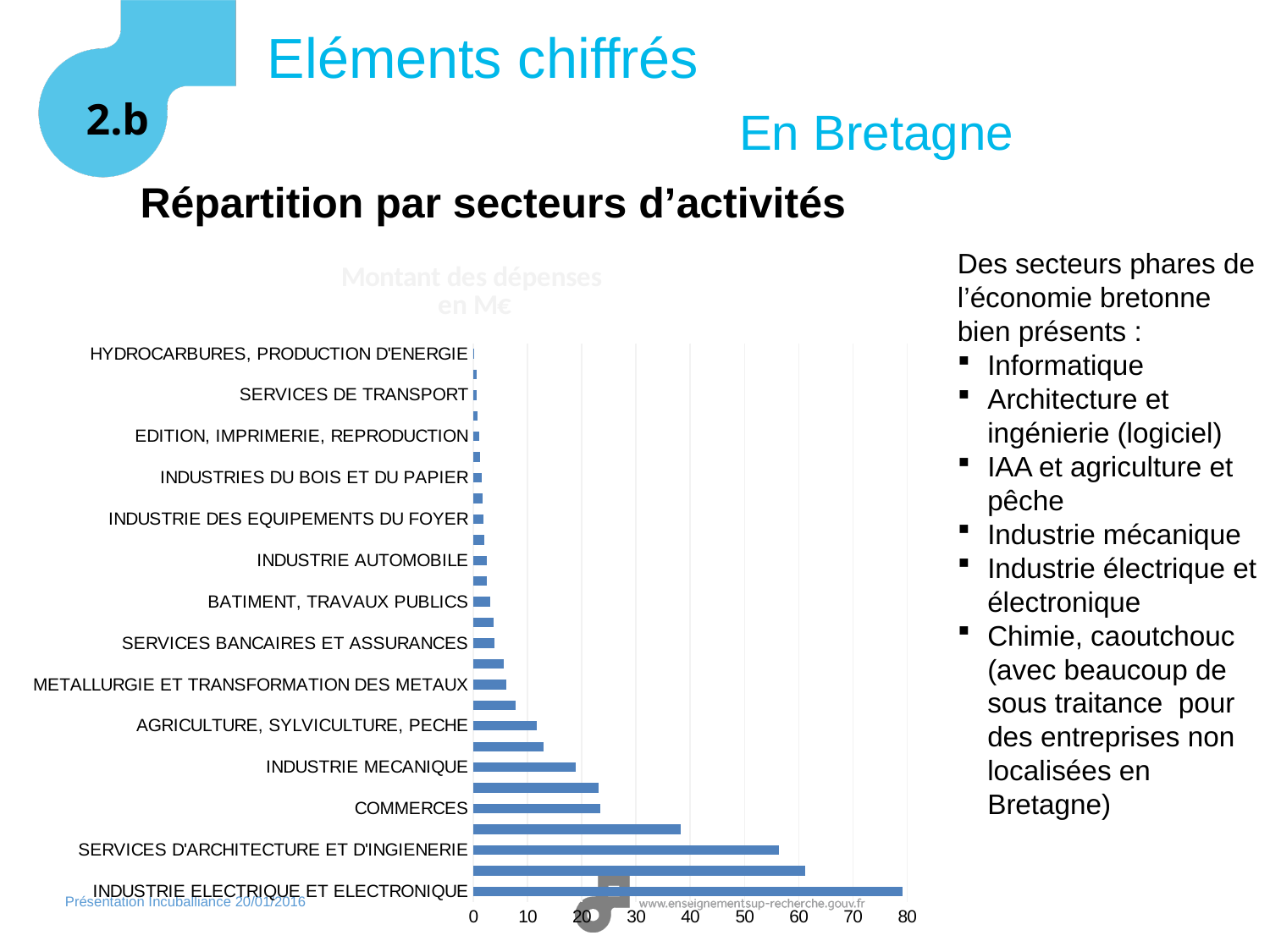
Which sector has the highest value in the chart? INDUSTRIE ELECTRIQUE ET ELECTRONIQUE Is the value for METALLURGIE ET TRANSFORMATION DES METAUX greater or less than 10? less Is the value for AGRICULTURE, SYLVICULTURE, PECHE greater or less than 20? less Is the value for SERVICES D'ARCHITECTURE ET D'INGIENERIE greater or less than 50? greater What is the highest value shown on the horizontal axis of the chart? 80 Which is larger, the value for SERVICES D'ARCHITECTURE ET D'INGIENERIE or the value for COMMERCES? SERVICES D'ARCHITECTURE ET D'INGIENERIE What kind of chart is shown on the slide? bar chart Which is larger, the value for INDUSTRIE ELECTRIQUE ET ELECTRONIQUE or the value for SERVICES D'ARCHITECTURE ET D'INGIENERIE? INDUSTRIE ELECTRIQUE ET ELECTRONIQUE What is the title of the chart? Montant des dépenses en M€